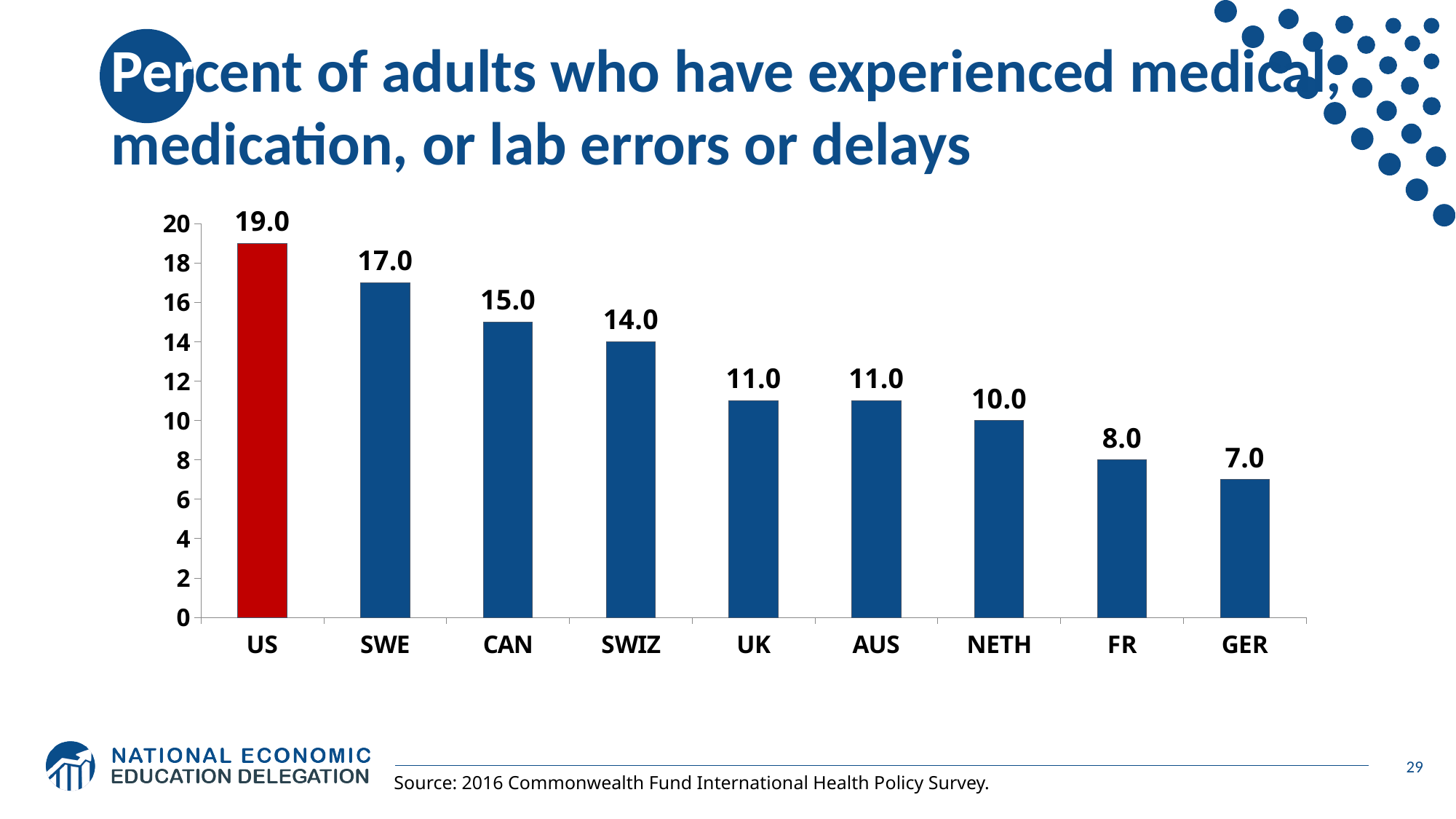
Which is larger, the value for FR or the value for NETH? NETH What is the difference between the values for CAN and GER? 8.0 What is the value for NETH? 10.0 How many countries are shown on the chart? 9 Which country has the highest value? US What is the value for the US? 19.0 Which bar is coloured red rather than blue? US Which country has the lowest value? GER What is the difference between the values for the US and SWE? 2.0 What kind of chart is shown on the slide? bar chart Do the values rise or fall from left to right along the x axis? fall What is the value for SWIZ? 14.0